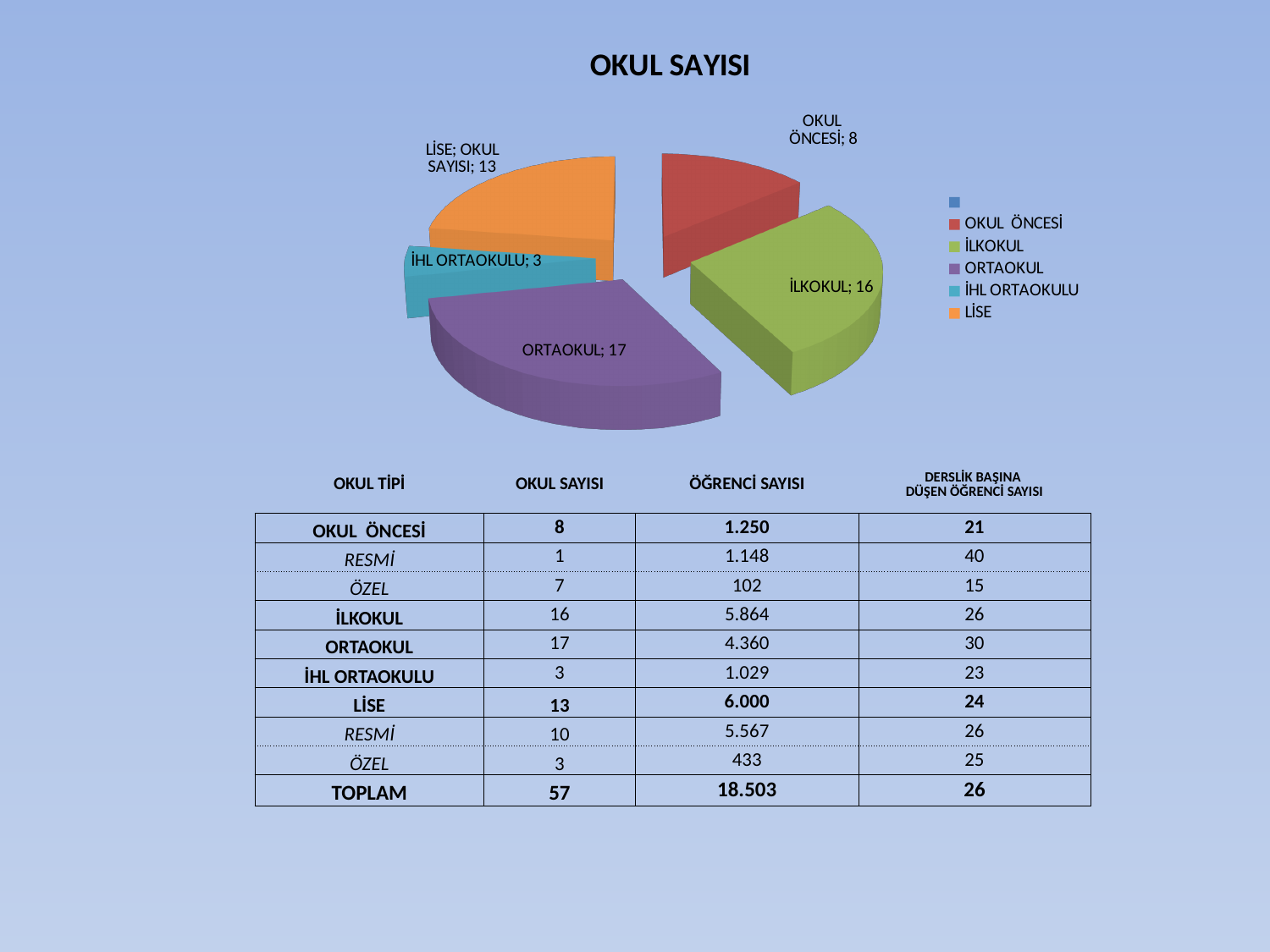
What is the value for OKUL ÖNCESİ in the pie chart? 8 Which category has the smallest slice in the pie chart? İHL ORTAOKULU What is the difference between the values for ORTAOKUL and LİSE in the pie chart? 4 What is the value for İLKOKUL in the pie chart? 16 Which category has the largest slice in the pie chart? ORTAOKUL What colour is the ORTAOKUL slice in the pie chart? purple Which is larger in the pie chart, İLKOKUL or OKUL ÖNCESİ? İLKOKUL What type of chart is shown on the slide? pie chart What is the value for ORTAOKUL in the pie chart? 17 How many slices does the pie chart have? 5 What is the title of the chart? OKUL SAYISI What is the value for LİSE in the pie chart? 13